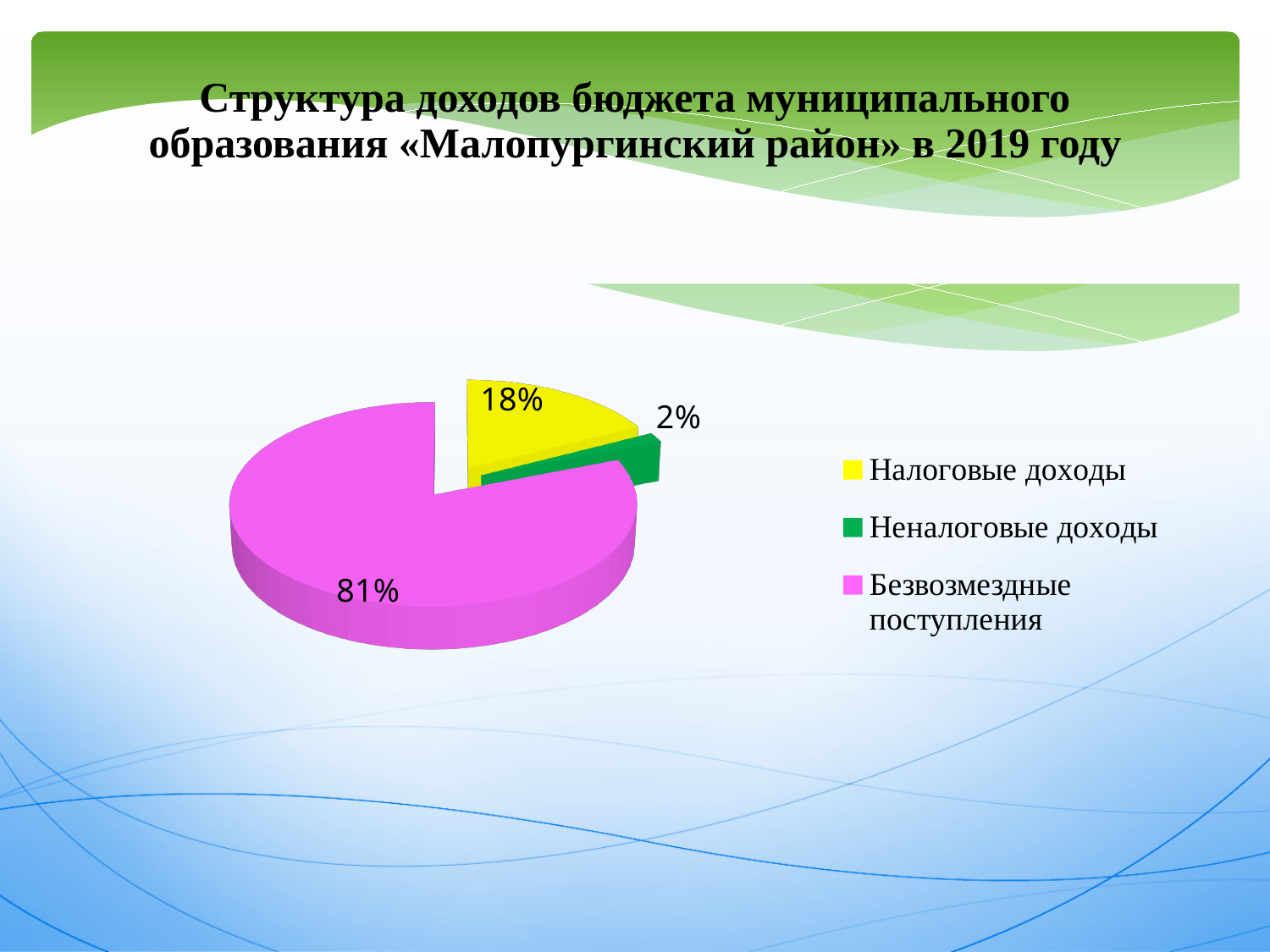
Which is larger, Налоговые доходы or Неналоговые доходы? Налоговые доходы What is the title of the slide? Структура доходов бюджета муниципального образования «Малопургинский район» в 2019 году What is the difference in percentage points between Налоговые доходы and Неналоговые доходы? 16 Which category has the smallest slice of the pie? Неналоговые доходы How many categories does the pie chart show? 3 What colour is the slice for Безвозмездные поступления? Pink What is the difference in percentage points between Безвозмездные поступления and Налоговые доходы? 63 What share of the pie is Налоговые доходы? 18% Which category has the largest slice of the pie? Безвозмездные поступления What kind of chart is shown on the slide? Pie chart What share of the pie is Неналоговые доходы? 2% What share of the pie is Безвозмездные поступления? 81%